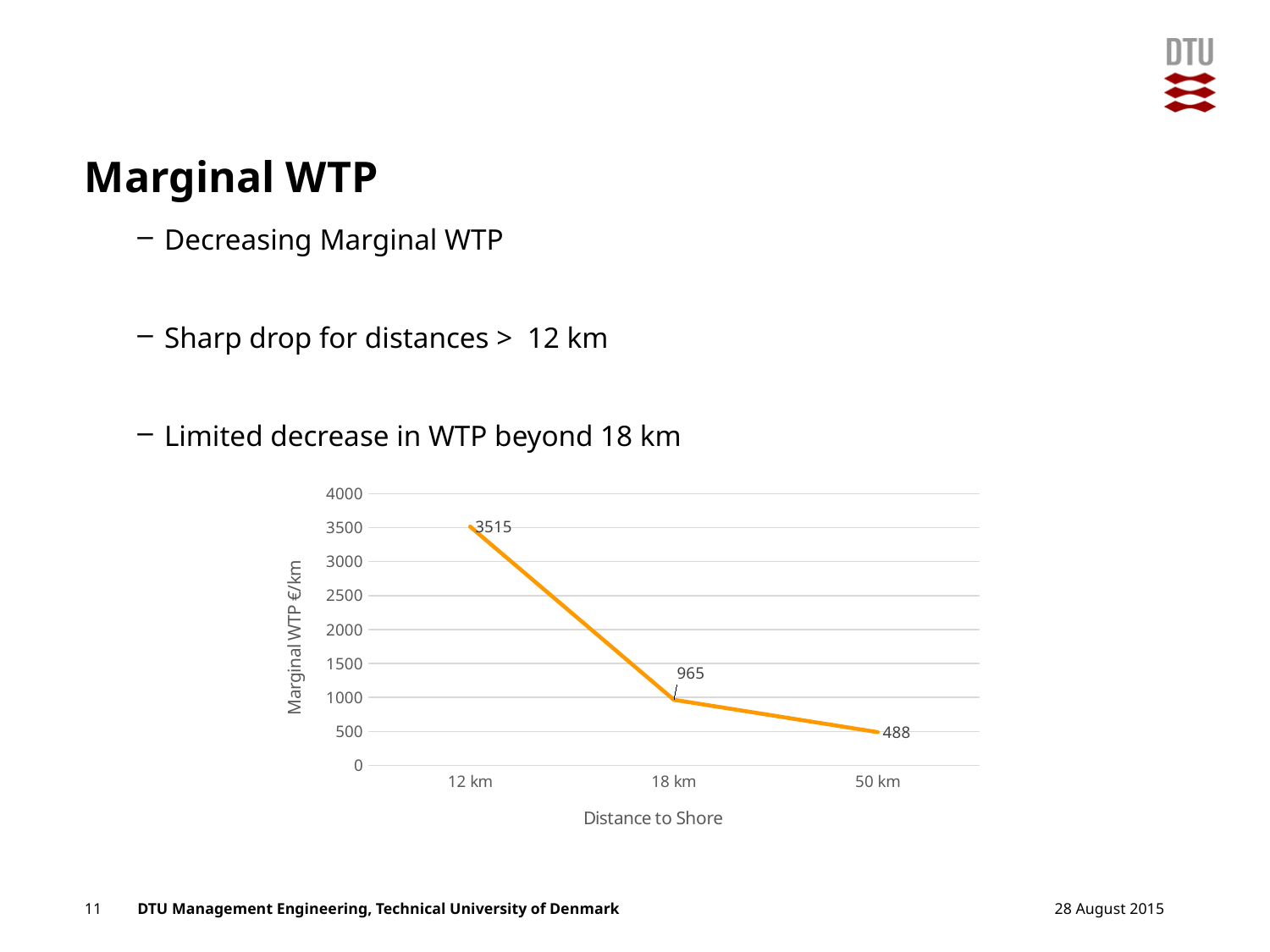
What kind of chart is shown on the slide? Line chart Which has a larger marginal WTP, 18 km or 50 km? 18 km What is the difference in marginal WTP between 18 km and 50 km? 477 What is the marginal WTP at 18 km distance to shore? 965 What is the difference in marginal WTP between 12 km and 18 km? 2550 Is the marginal WTP at 12 km greater or less than 3000? greater At which distance to shore is the marginal WTP highest? 12 km What is the marginal WTP at 12 km distance to shore? 3515 Does the marginal WTP rise or fall as distance to shore increases? Fall What is the marginal WTP at 50 km distance to shore? 488 At which distance to shore is the marginal WTP lowest? 50 km How many distance categories are plotted on the x axis? 3